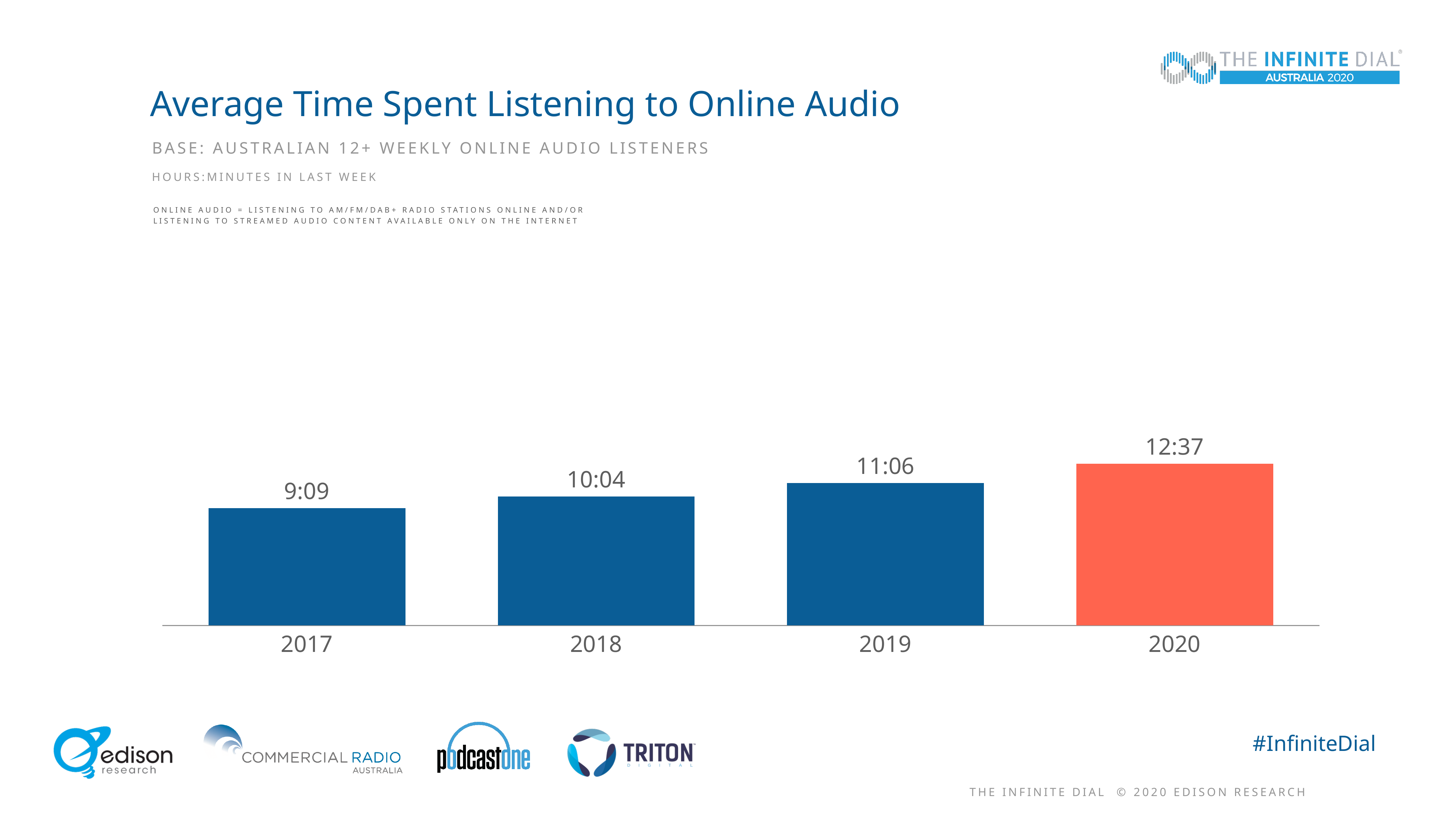
How much greater is the 2020 value than the 2019 value, in hours:minutes? 1:31 How many years are shown on the chart? 4 Which year has the highest average time spent listening to online audio? 2020 What kind of chart is shown on the slide? Bar chart Do the values rise or fall from 2017 to 2020? Rise What is the value shown for 2018? 10:04 Which year's bar is coloured differently (orange) from the others? 2020 What is the value shown for 2019? 11:06 What is the average time spent listening to online audio in 2017? 9:09 What is the average time spent listening to online audio in 2020? 12:37 Which year has the larger value, 2018 or 2019? 2019 Which year has the lowest average time spent listening to online audio? 2017